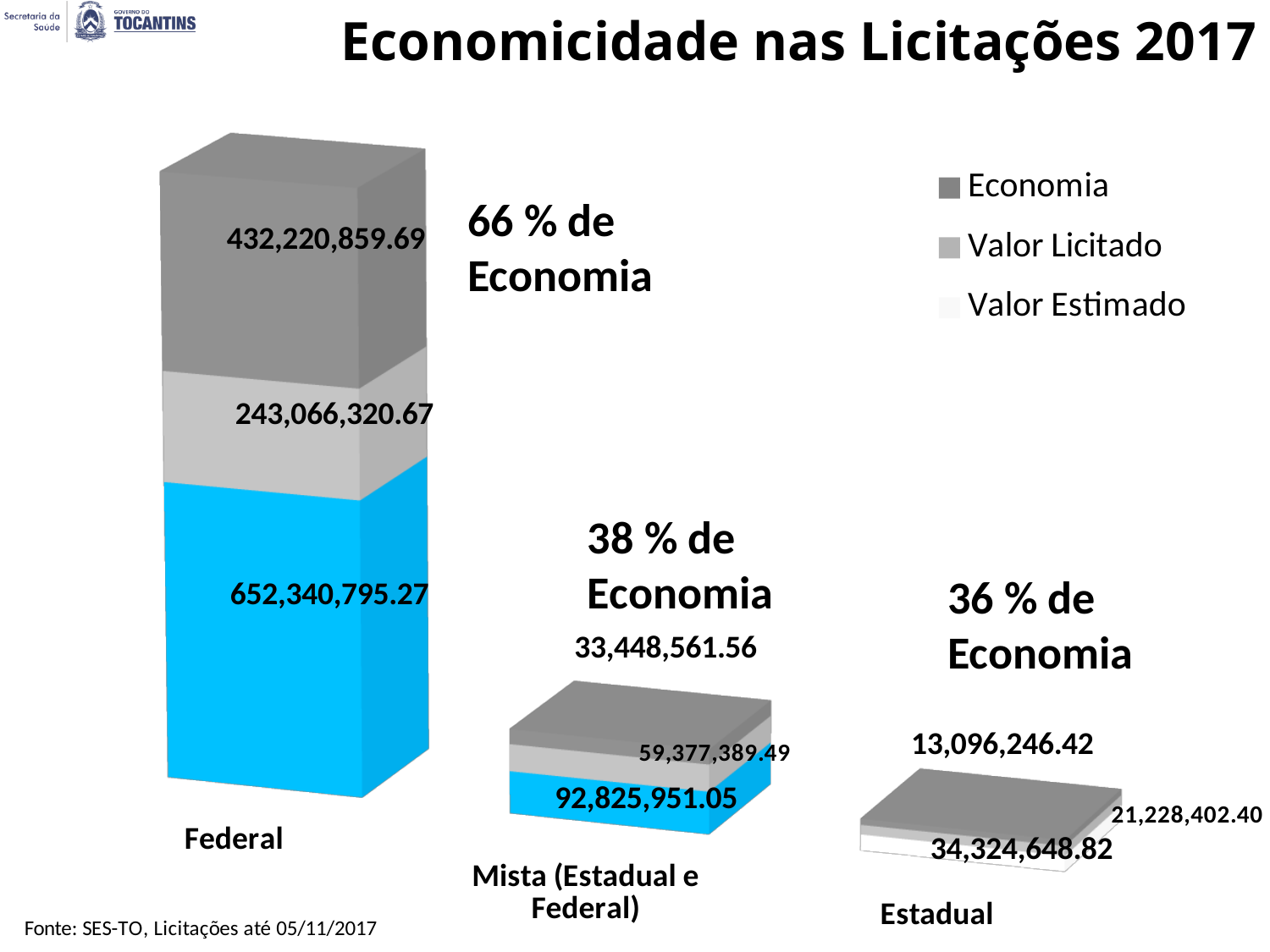
What is the Valor Estimado value for the Mista (Estadual e Federal) category? 92,825,951.05 What is the Economia value for the Federal category? 432,220,859.69 What is the Valor Licitado value for the Federal category? 243,066,320.67 Is the Valor Estimado for Mista (Estadual e Federal) larger or smaller than the Valor Estimado for Estadual? larger What is the Valor Licitado value for the Estadual category? 21,228,402.40 Which category has the lowest Economia value? Estadual Which category has the highest Valor Estimado? Federal How many categories are shown on the x axis of the chart? 3 How many series does the legend list? 3 What percentage of Economia is shown for the Estadual category? 36 % What is the difference between the Economia value for Federal and the Economia value for Mista (Estadual e Federal)? 398,772,298.13 What is the Economia value for the Estadual category? 13,096,246.42